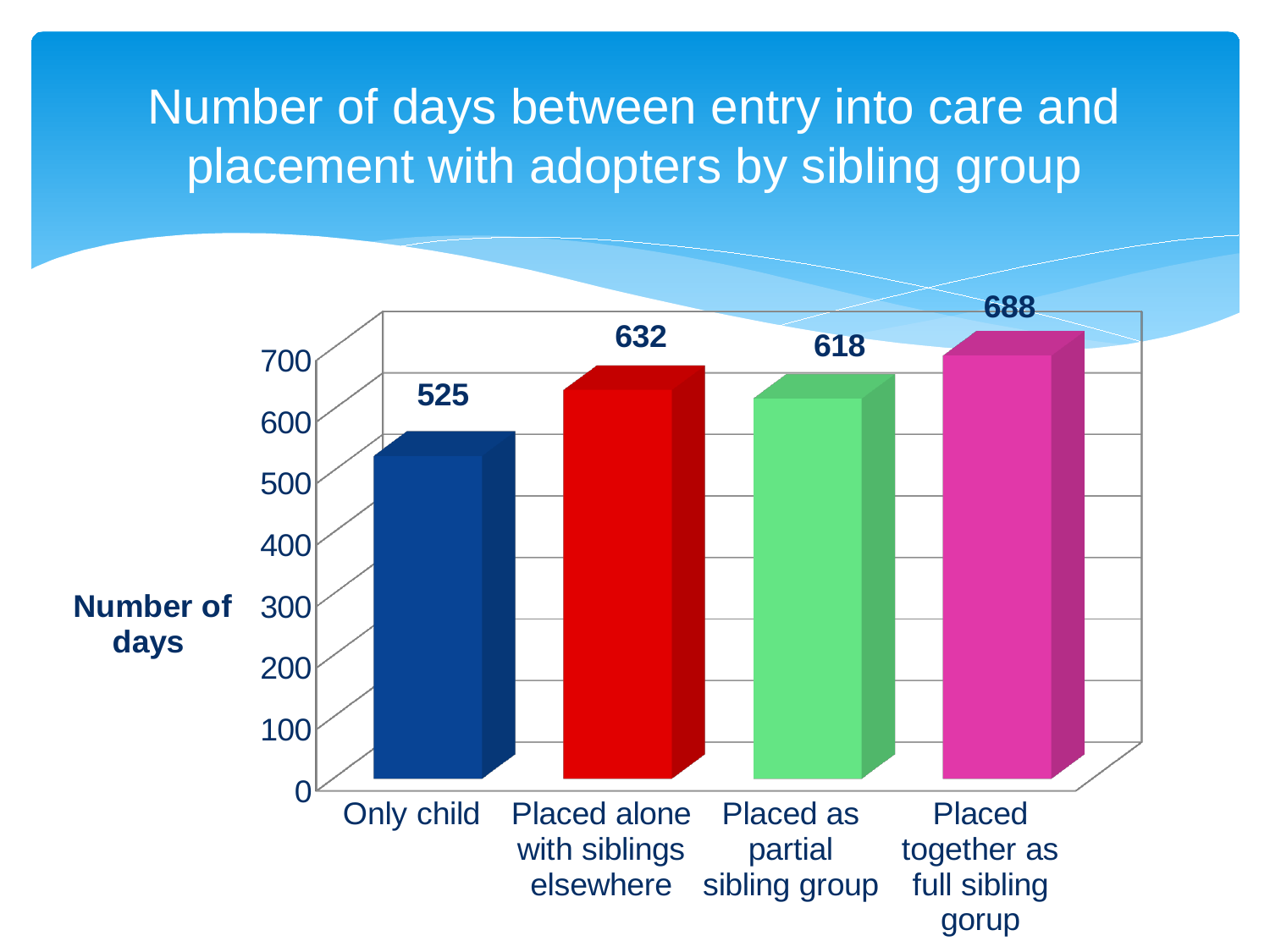
What is the difference in days between Placed together as full sibling group and Only child? 163 Which is larger: the value for Placed alone with siblings elsewhere or the value for Only child? Placed alone with siblings elsewhere What is the difference in days between Placed alone with siblings elsewhere and Placed as partial sibling group? 14 What is the number of days for Only child? 525 What is the label on the vertical axis of the chart? Number of days What is the number of days for Placed as partial sibling group? 618 What is the number of days for Placed alone with siblings elsewhere? 632 Which category has the highest number of days? Placed together as full sibling group How many categories are shown on the chart? 4 What is the number of days for Placed together as full sibling group? 688 Which category has the lowest number of days? Only child What kind of chart is shown on the slide? Bar chart